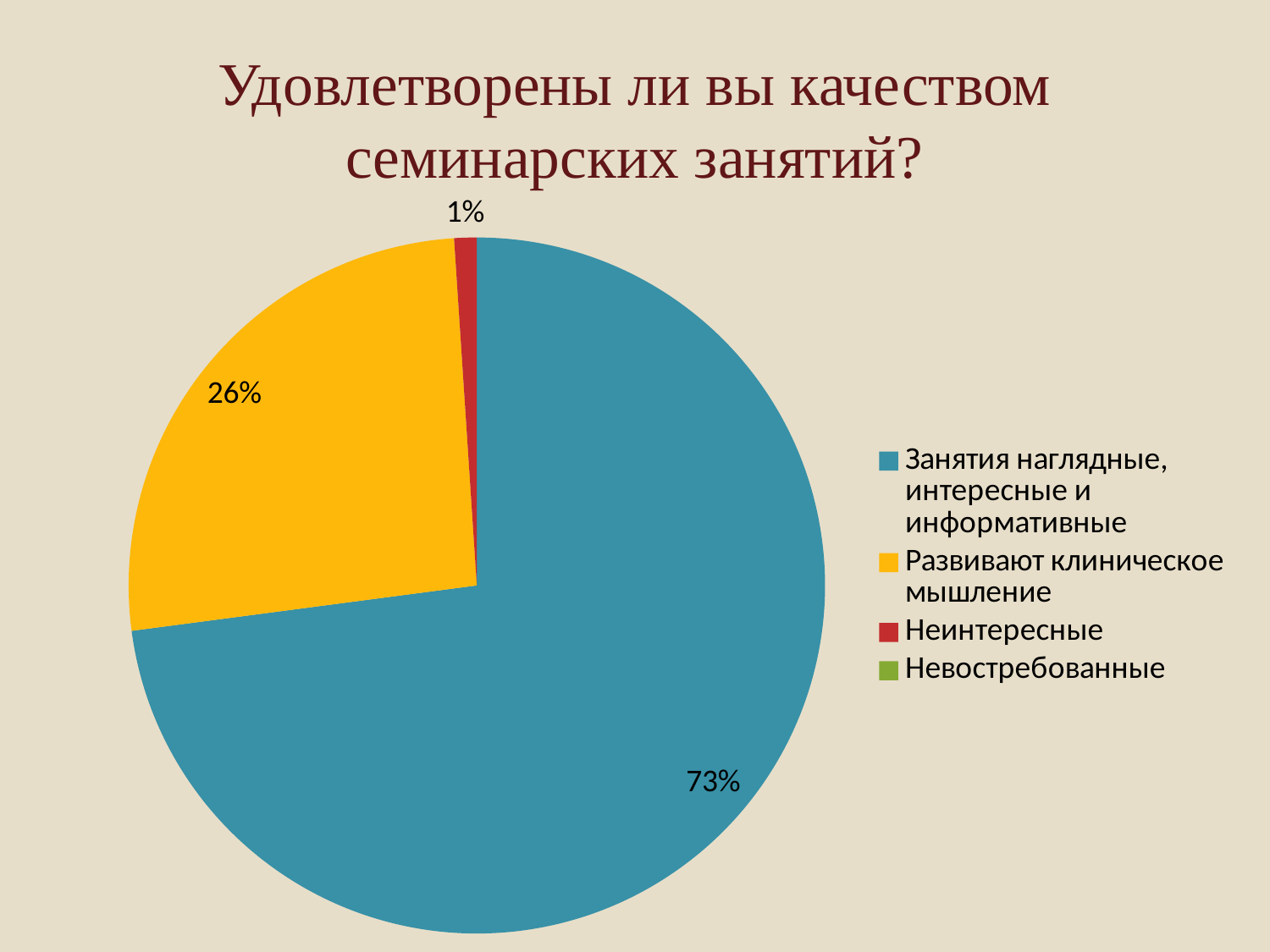
What share of the pie is labelled for "Занятия наглядные, интересные и информативные"? 73% Which labelled slice is the smallest? Неинтересные What colour is the slice for "Развивают клиническое мышление"? yellow Which is larger: the slice for "Развивают клиническое мышление" or the slice for "Неинтересные"? Развивают клиническое мышление How many categories does the legend list? 4 What is the title of the chart? Удовлетворены ли вы качеством семинарских занятий? What is the combined share of the "Развивают клиническое мышление" and "Неинтересные" slices? 27% What kind of chart is shown on the slide? pie chart Which category has the largest slice of the pie? Занятия наглядные, интересные и информативные What is the difference in percentage points between the "Занятия наглядные, интересные и информативные" slice and the "Развивают клиническое мышление" slice? 47 What share of the pie is labelled for "Неинтересные"? 1% What share of the pie is labelled for "Развивают клиническое мышление"? 26%